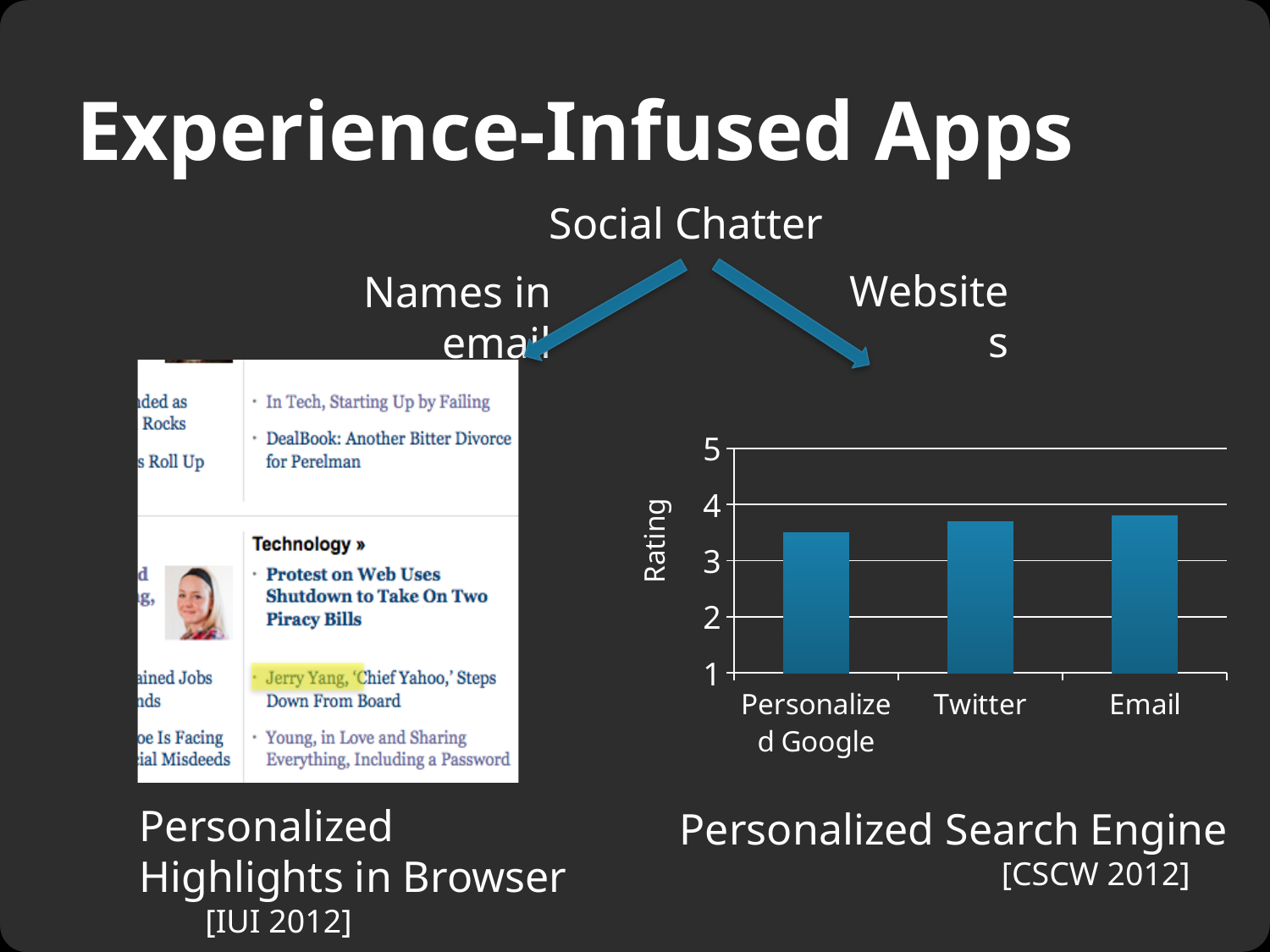
What is the highest value shown on the vertical axis of the bar chart? 5 Is the rating for Twitter greater or less than 4? less How many categories are plotted in the bar chart? 3 Is the rating for Email greater or less than 3? greater What kind of chart is shown on the slide? bar chart What is the label of the vertical axis of the bar chart? Rating Which category has the lowest rating in the bar chart? Personalized Google Which has a higher rating, Personalized Google or Email? Email Is the rating for Personalized Google greater or less than 3? greater